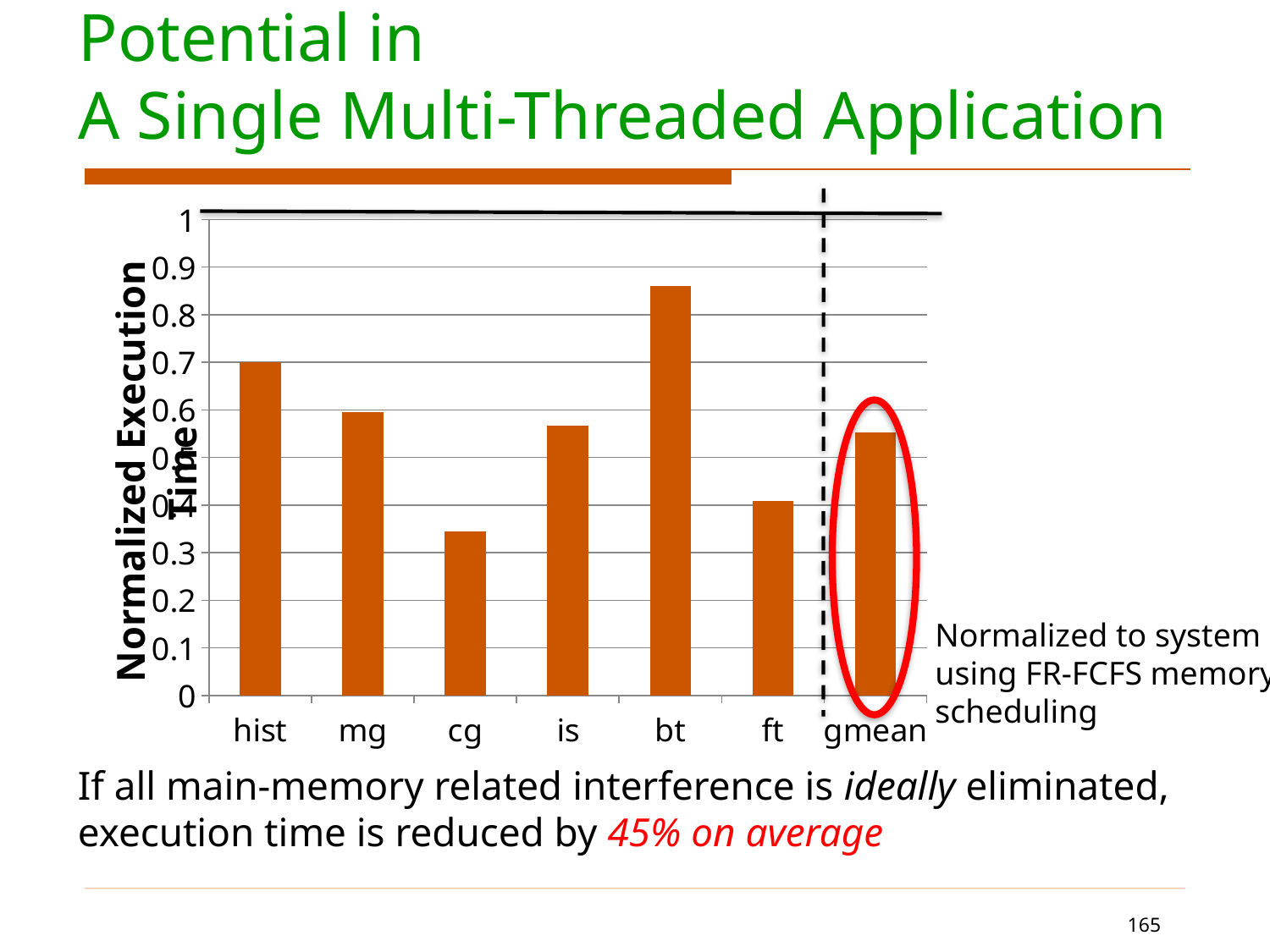
How many categories are shown on the x axis of the chart? 7 Is the value for gmean greater or less than 0.6? less Is the value for cg greater or less than 0.4? less Which category's bar is circled in red on the chart? gmean Which has a higher normalized execution time, bt or ft? bt Is the value for ft greater or less than 0.5? less Which has a higher normalized execution time, hist or mg? hist Which category has the lowest normalized execution time? cg What kind of chart is shown on the slide? bar chart Which category has the highest normalized execution time? bt What is the label of the y axis? Normalized Execution Time